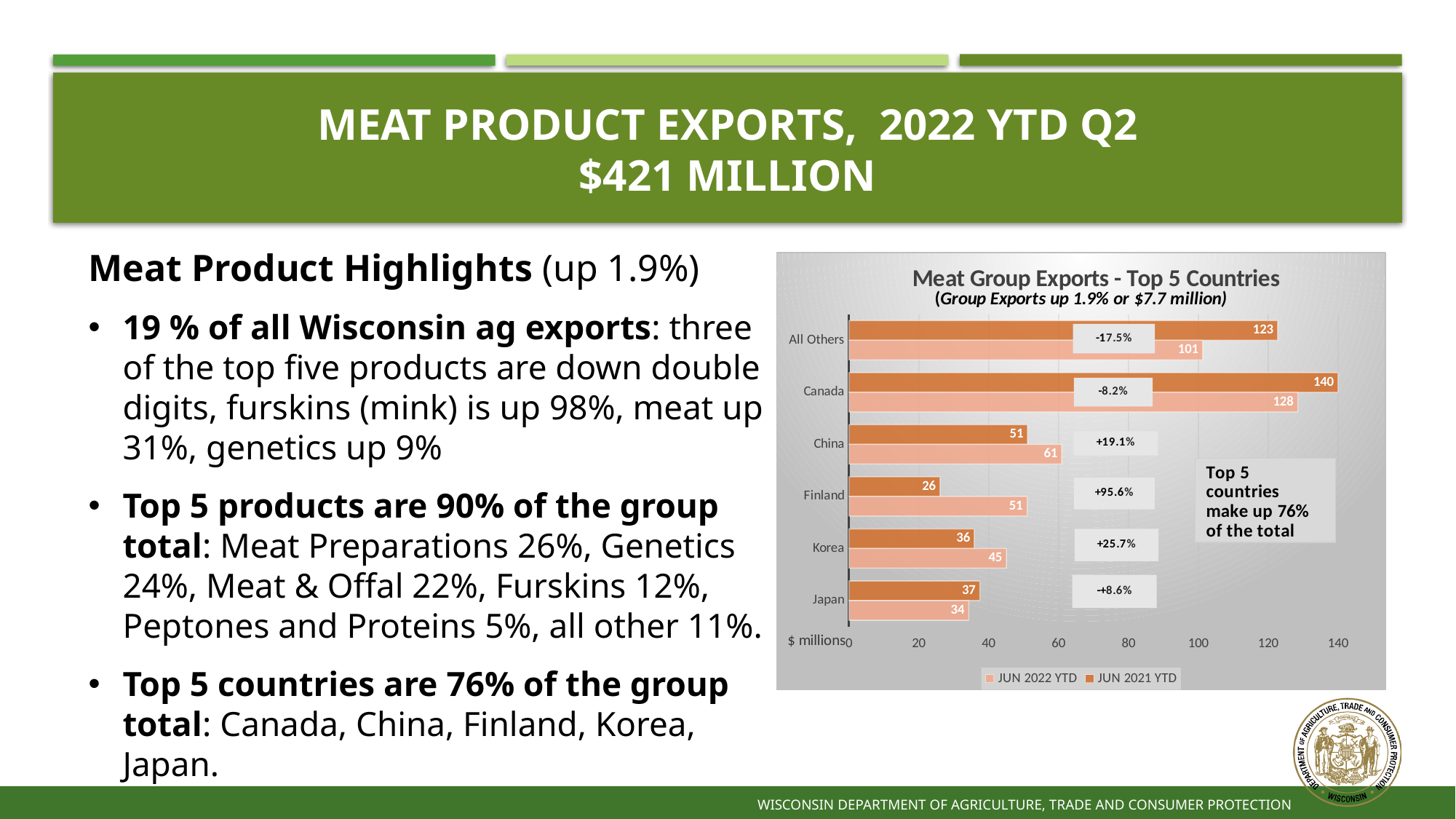
How many countries/categories are plotted on the chart? 6 What is the JUN 2021 YTD value for Finland? 26 Which is larger for Korea, the JUN 2022 YTD value or the JUN 2021 YTD value? JUN 2022 YTD Which category has the lowest JUN 2022 YTD value? Japan What is the difference between the JUN 2021 YTD and JUN 2022 YTD values for All Others? 22 What type of chart is shown on the slide? Bar chart What is the JUN 2022 YTD value for China? 61 What is the title of the chart? Meat Group Exports - Top 5 Countries What percentage change is shown for Finland on the chart? +95.6% How many series does the legend of the chart list? 2 Which category has the highest JUN 2021 YTD value? Canada What is the JUN 2022 YTD value for Canada? 128